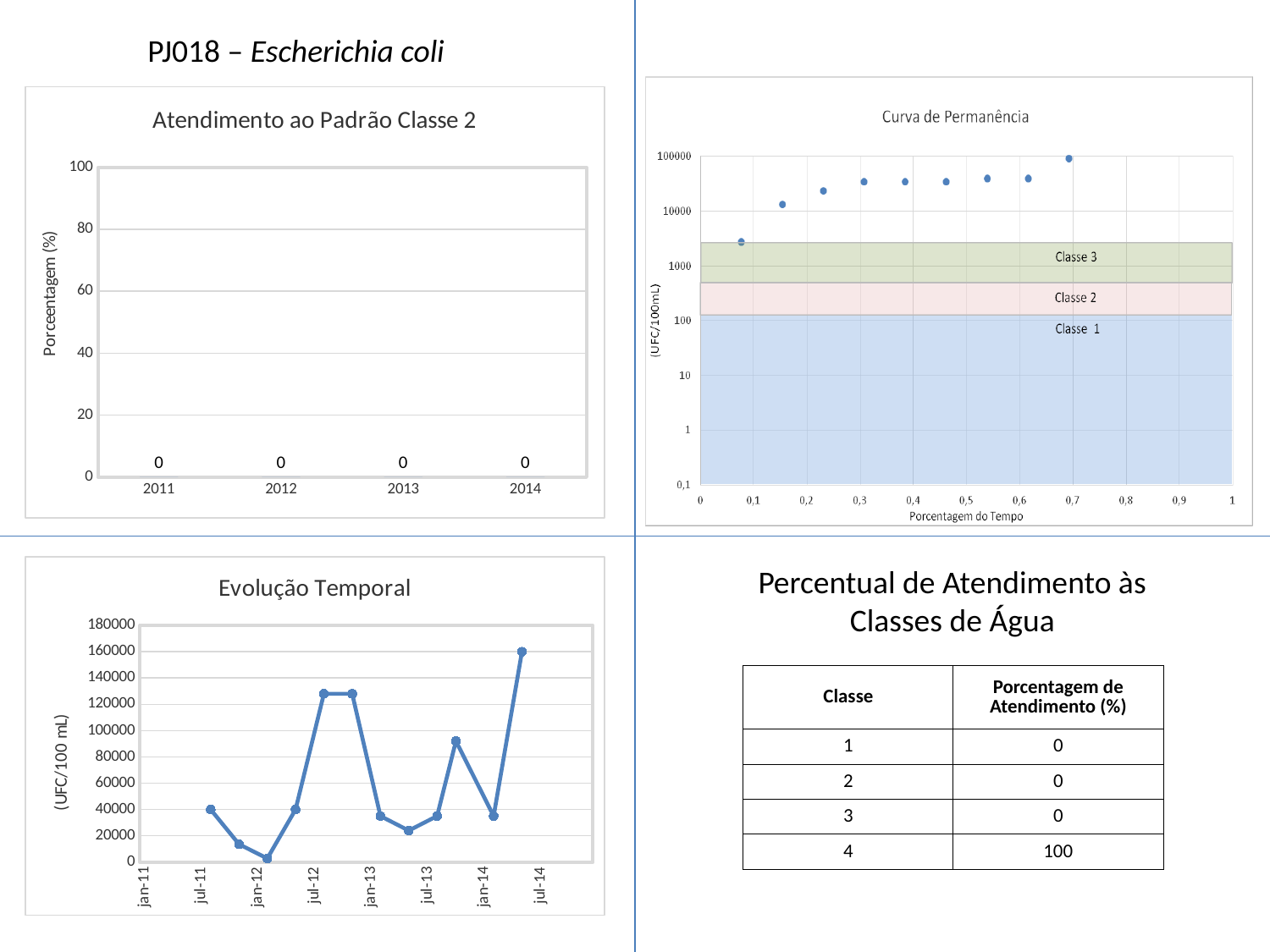
What kind of chart is 'Atendimento ao Padrão Classe 2'? bar chart In the 'Evolução Temporal' chart, is the value of the point at jan-12 greater or less than 20000? less In the 'Atendimento ao Padrão Classe 2' chart, what is the value for 2013? 0 In the 'Curva de Permanência' chart, which class band is shaded green? Classe 3 In the 'Atendimento ao Padrão Classe 2' chart, what is the label of the y axis? Porceentagem (%) In the 'Evolução Temporal' chart, which is larger: the value at jul-11 or the value at jan-12? jul-11 In the 'Curva de Permanência' chart, do the plotted values rise or fall as Porcentagem do Tempo increases? rise In the 'Evolução Temporal' chart, how many data points are plotted? 12 What kind of chart is 'Evolução Temporal'? line chart In the 'Curva de Permanência' chart, is the value of the point at 0.7 on the x axis greater or less than 10000? greater In the 'Evolução Temporal' chart, is the value of the last point (jul-14) greater or less than 140000? greater In the 'Atendimento ao Padrão Classe 2' chart, how many years are shown on the x axis? 4